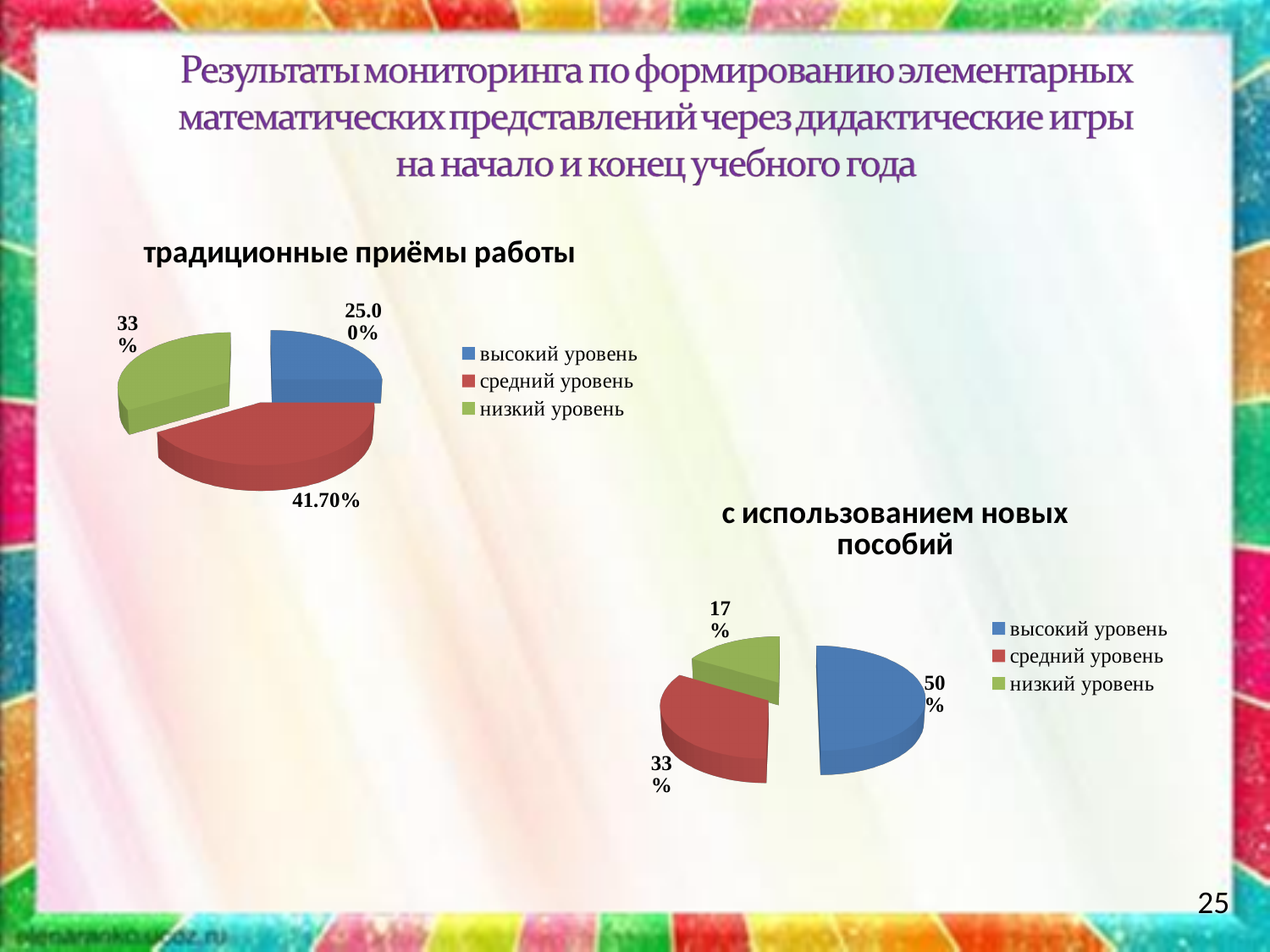
In the 'традиционные приёмы работы' chart, which colour represents 'низкий уровень'? green In the 'традиционные приёмы работы' chart, which level has the smallest share? высокий уровень In the 'традиционные приёмы работы' chart, what is the value for 'средний уровень'? 41.70% What type of chart is used on the slide for 'традиционные приёмы работы'? pie chart In the 'традиционные приёмы работы' chart, what is the value for 'высокий уровень'? 25.00% In the 'традиционные приёмы работы' chart, which level has the largest share? средний уровень In the 'с использованием новых пособий' chart, which level has the largest share? высокий уровень How many entries does the legend of the 'с использованием новых пособий' chart list? 3 In the 'традиционные приёмы работы' chart, what is the value for 'низкий уровень'? 33% In the 'с использованием новых пособий' chart, what is the value for 'низкий уровень'? 17% In the 'с использованием новых пособий' chart, what is the value for 'высокий уровень'? 50% In the 'с использованием новых пособий' chart, what is the difference between 'высокий уровень' and 'средний уровень'? 17%